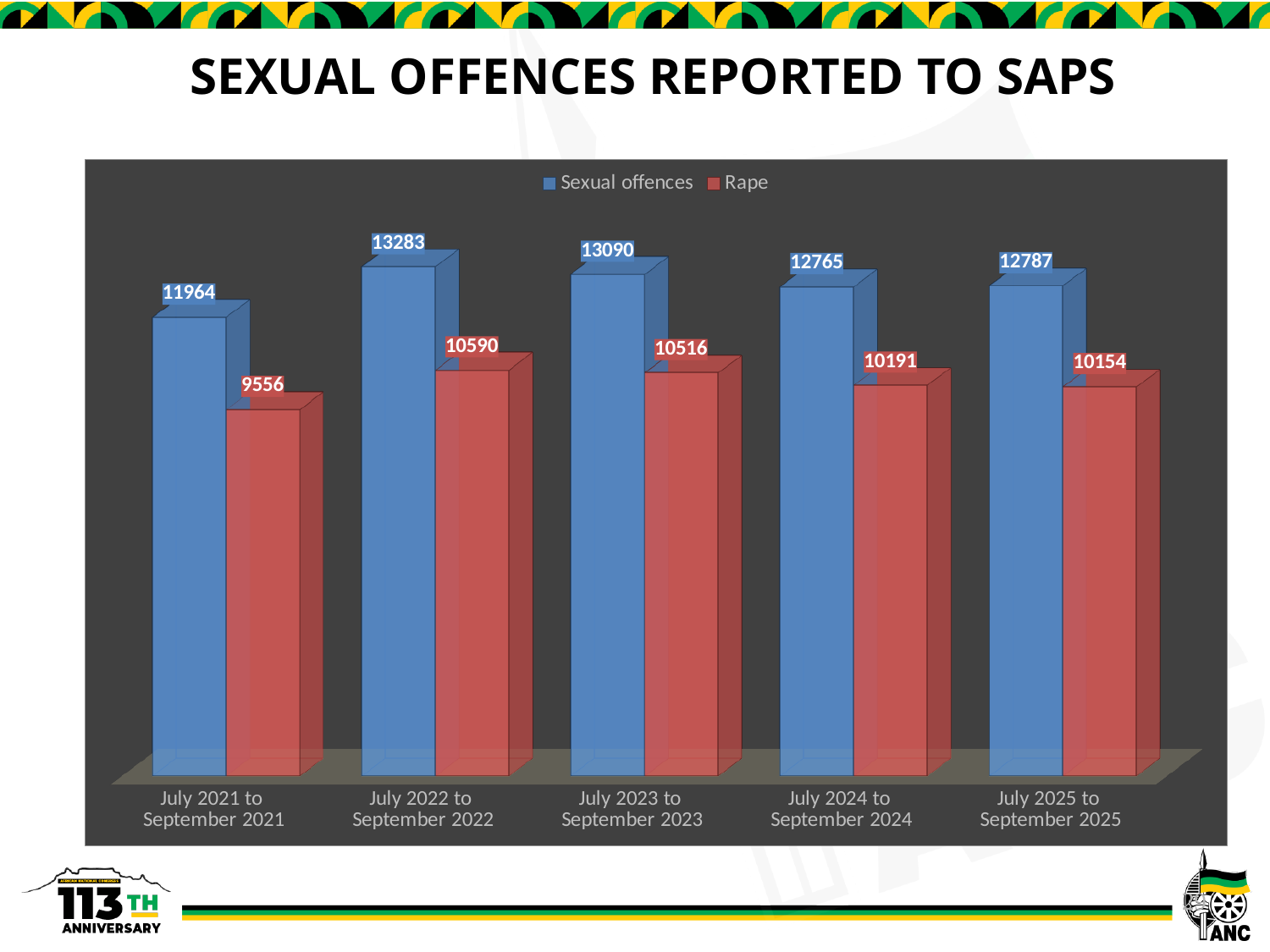
Which is larger: the Rape value in July 2022 to September 2022 or in July 2021 to September 2021? July 2022 to September 2022 In which period is the Sexual offences value highest? July 2022 to September 2022 What is the difference between the Sexual offences values for July 2022 to September 2022 and July 2021 to September 2021? 1319 What is the value for Sexual offences in July 2021 to September 2021? 11964 In which period is the Rape value lowest? July 2021 to September 2021 What is the difference between Sexual offences and Rape in July 2022 to September 2022? 2693 From July 2022 to September 2022 through July 2025 to September 2025, do the Rape values rise or fall? Fall How many series does the legend list? 2 What is the value for Sexual offences in July 2025 to September 2025? 12787 How many reporting periods are shown on the x axis? 5 What type of chart is shown on the slide? Bar chart What is the value for Rape in July 2024 to September 2024? 10191